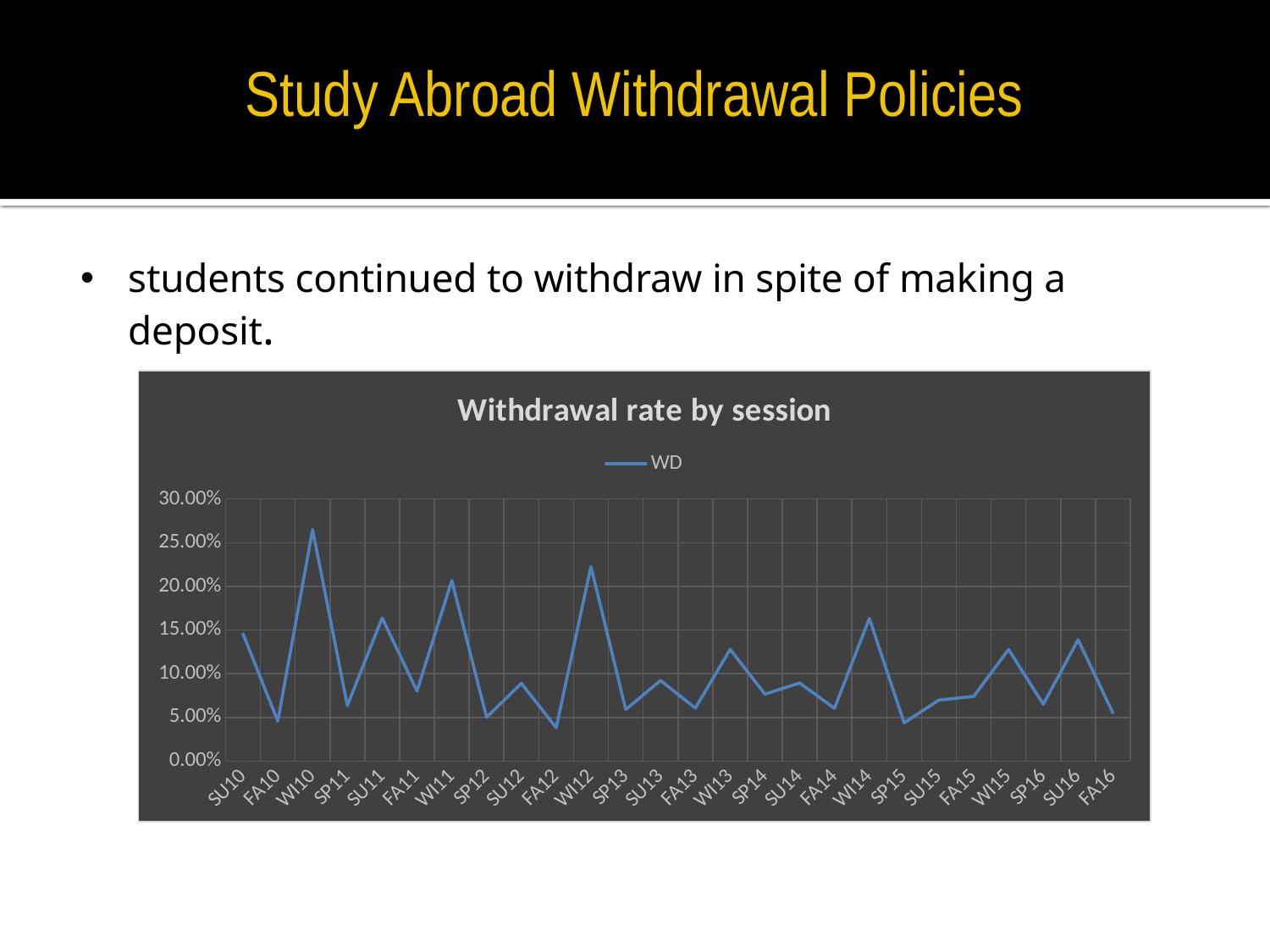
Is the value for FA10 greater or less than 10.00%? less Does the withdrawal rate rise or fall from WI10 to SP11? fall What kind of chart is shown on the slide? line chart Is the value for SU16 greater or less than 10.00%? greater Is the value for WI10 greater or less than 20.00%? greater What is the title of the chart? Withdrawal rate by session What is the name of the series shown in the legend? WD How many sessions are plotted along the x axis? 26 Which has the higher withdrawal rate, WI10 or WI12? WI10 Which session has the highest withdrawal rate? WI10 How many series does the legend list? 1